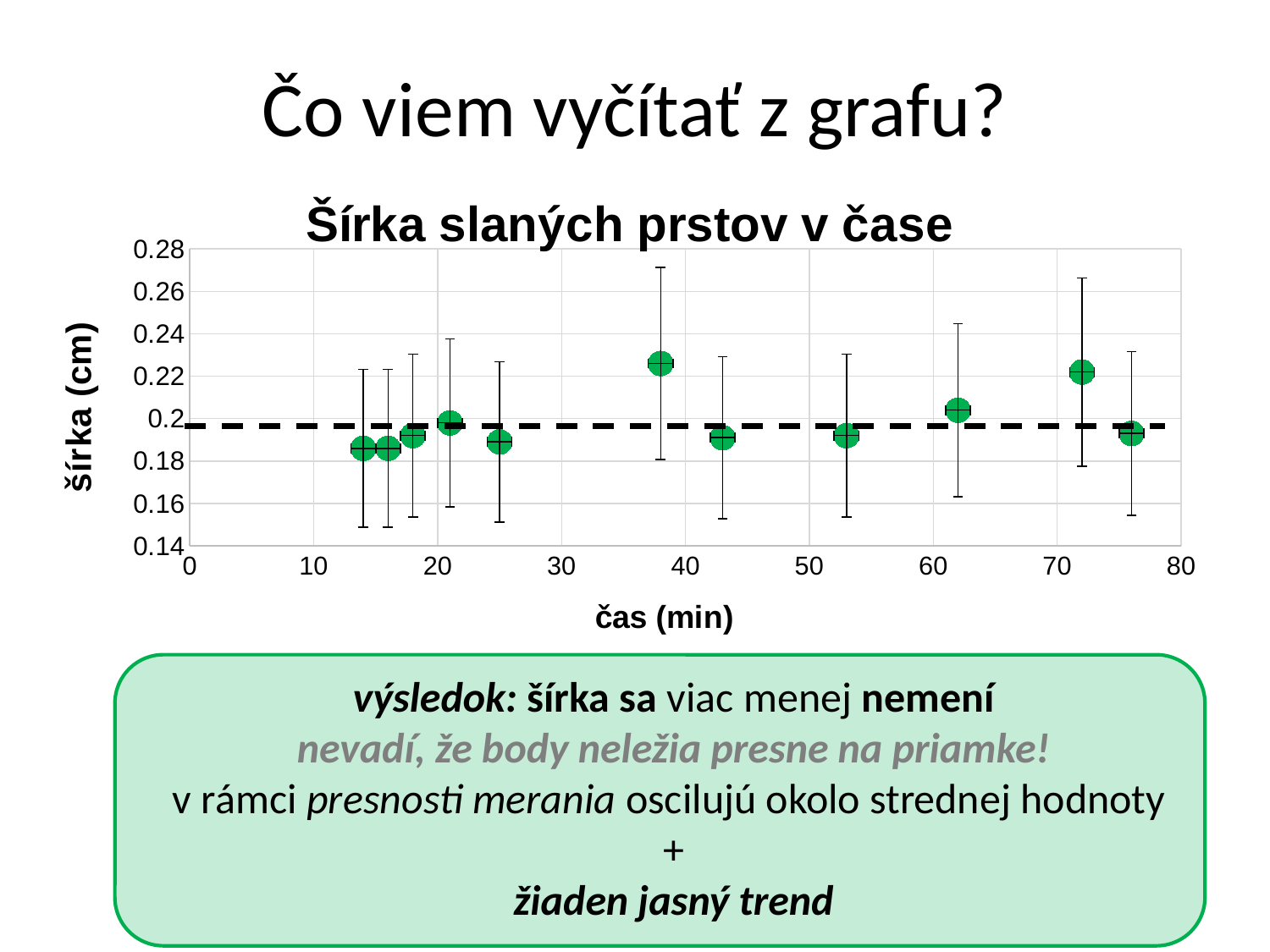
Is the value for the point at about 38 min greater or less than 0.2? greater What is the highest value shown on the y axis? 0.28 Which has the larger width value: the point at about 38 min or the point at about 14 min? the point at about 38 min Is the value for the point at about 14 min greater or less than 0.2? less What is the title of the chart? Šírka slaných prstov v čase What kind of chart is shown on the slide? scatter chart Which has the larger width value: the point at about 72 min or the point at about 25 min? the point at about 72 min Do the plotted values show a clear rising or falling trend along the x axis? no clear trend How many data points are plotted in the chart? 11 What is the label of the x axis? čas (min) Is the value for the point at about 53 min greater or less than 0.2? less